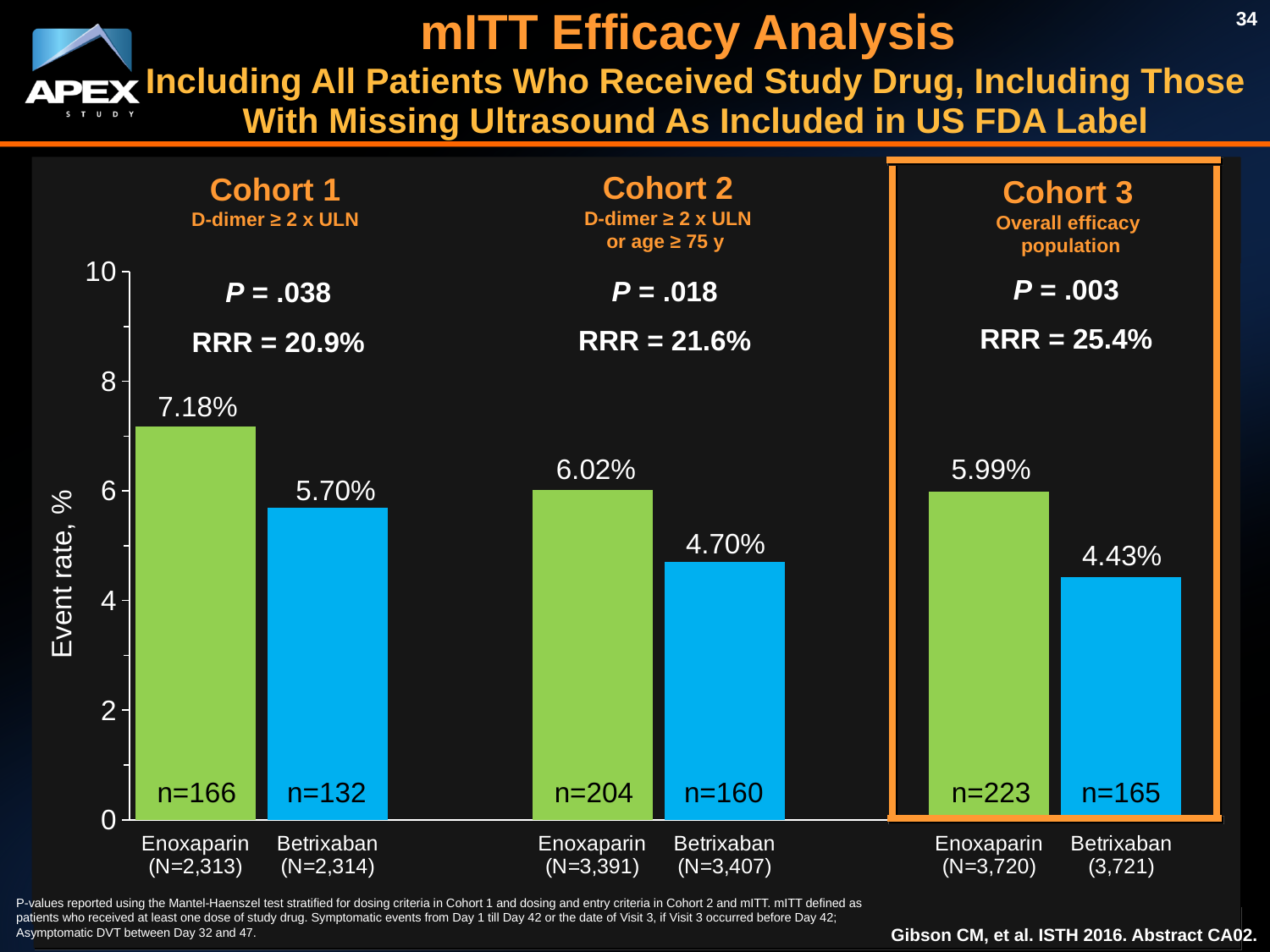
What kind of chart is shown on the slide? Bar chart What is the event rate for Betrixaban in Cohort 3? 4.43% Which bar has the lowest event rate on the chart? Betrixaban in Cohort 3 (4.43%) What is the event rate for Enoxaparin in Cohort 1? 7.18% Which has the higher event rate in Cohort 2, Enoxaparin or Betrixaban? Enoxaparin Is the event rate for Enoxaparin in Cohort 2 greater or less than 6? greater Which bar has the highest event rate on the chart? Enoxaparin in Cohort 1 (7.18%) What is the difference in event rate between Enoxaparin and Betrixaban in Cohort 3? 1.56% What is the difference in event rate between Enoxaparin and Betrixaban in Cohort 1? 1.48% What is the event rate for Betrixaban in Cohort 2? 4.70% How many bars are plotted on the chart? 6 What is the RRR reported for Cohort 3? 25.4%